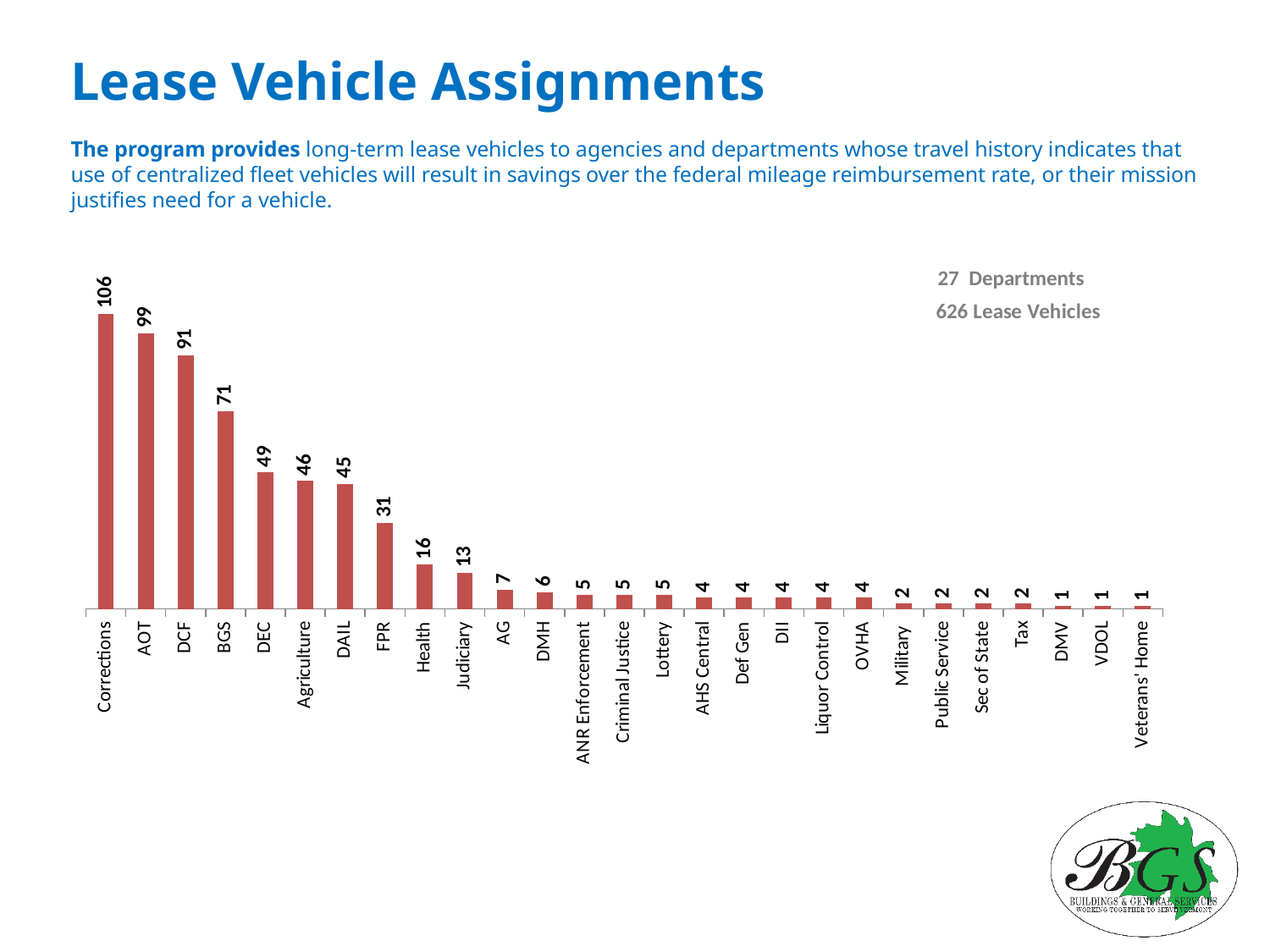
Which has more lease vehicles, Judiciary or AG? Judiciary How many lease vehicles are assigned to Lottery? 5 Do the values rise or fall moving from left to right along the x axis? fall What is the difference between the number of lease vehicles for AOT and DCF? 8 Which has more lease vehicles, Agriculture or DAIL? Agriculture How many lease vehicles are assigned to Corrections? 106 What kind of chart is shown on the slide? bar chart How many lease vehicles are assigned to DEC? 49 How many lease vehicles are assigned to Health? 16 Which department has the highest number of lease vehicles? Corrections What is the difference between the number of lease vehicles for BGS and FPR? 40 How many departments are shown on the x axis of the chart? 27